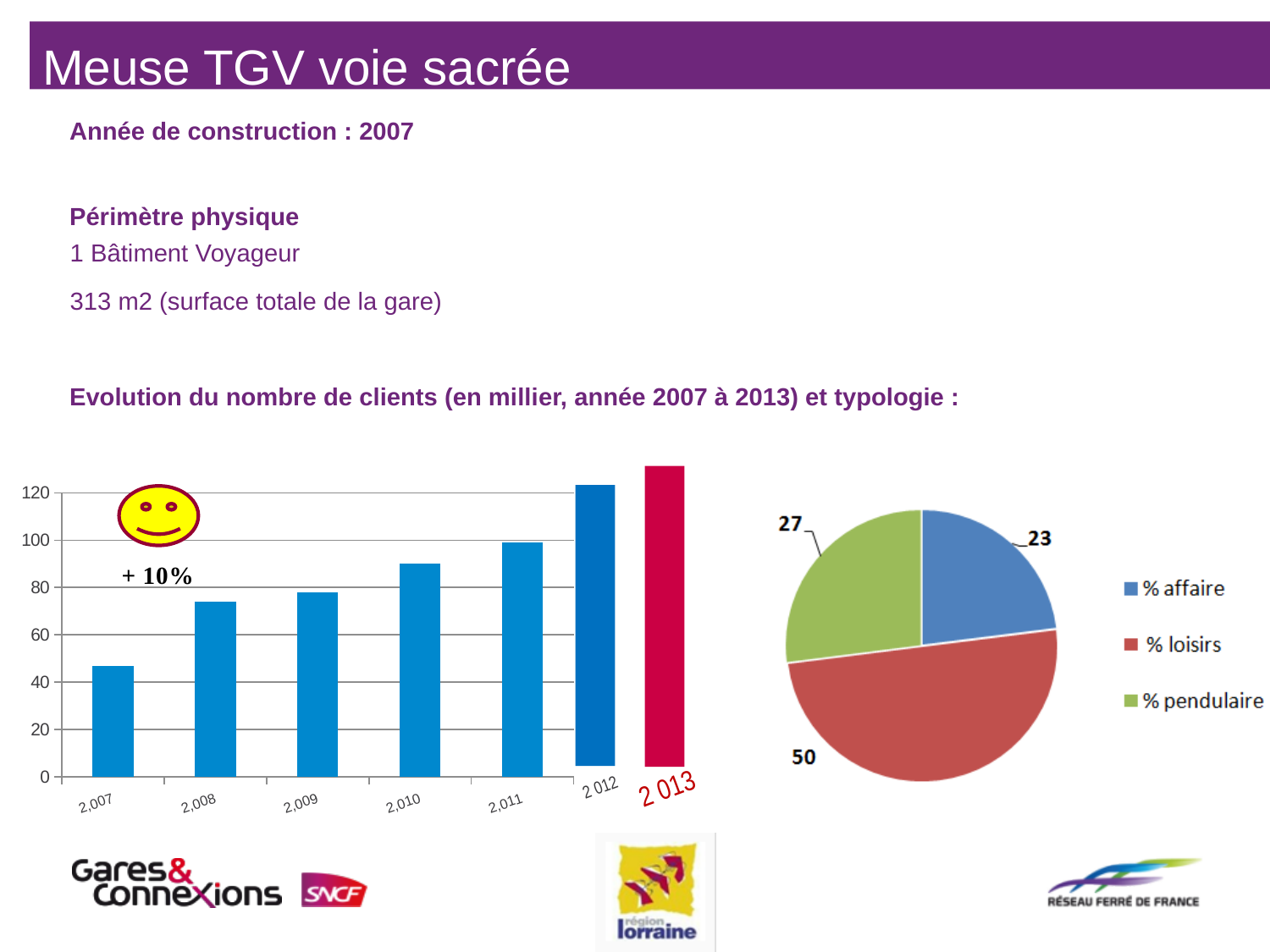
On the bar chart on the left, do the values rise or fall from 2007 to 2013? rise On the bar chart on the left, is the value for 2007 greater or less than 60? less On the bar chart on the left, which is larger, the value for 2008 or the value for 2011? 2011 On the pie chart on the right, which category has the smallest slice? % affaire On the bar chart on the left, which year has the highest value? 2013 On the bar chart on the left, how many years are plotted? 7 On the bar chart on the left, what kind of chart is it? bar chart On the bar chart on the left, is the value for 2012 greater or less than 120? greater On the pie chart on the right, what is the value for % loisirs? 50 On the pie chart on the right, what is the difference between % pendulaire and % affaire? 4 On the bar chart on the left, which year has the lowest value? 2007 On the bar chart on the left, is the value for 2010 greater or less than 80? greater